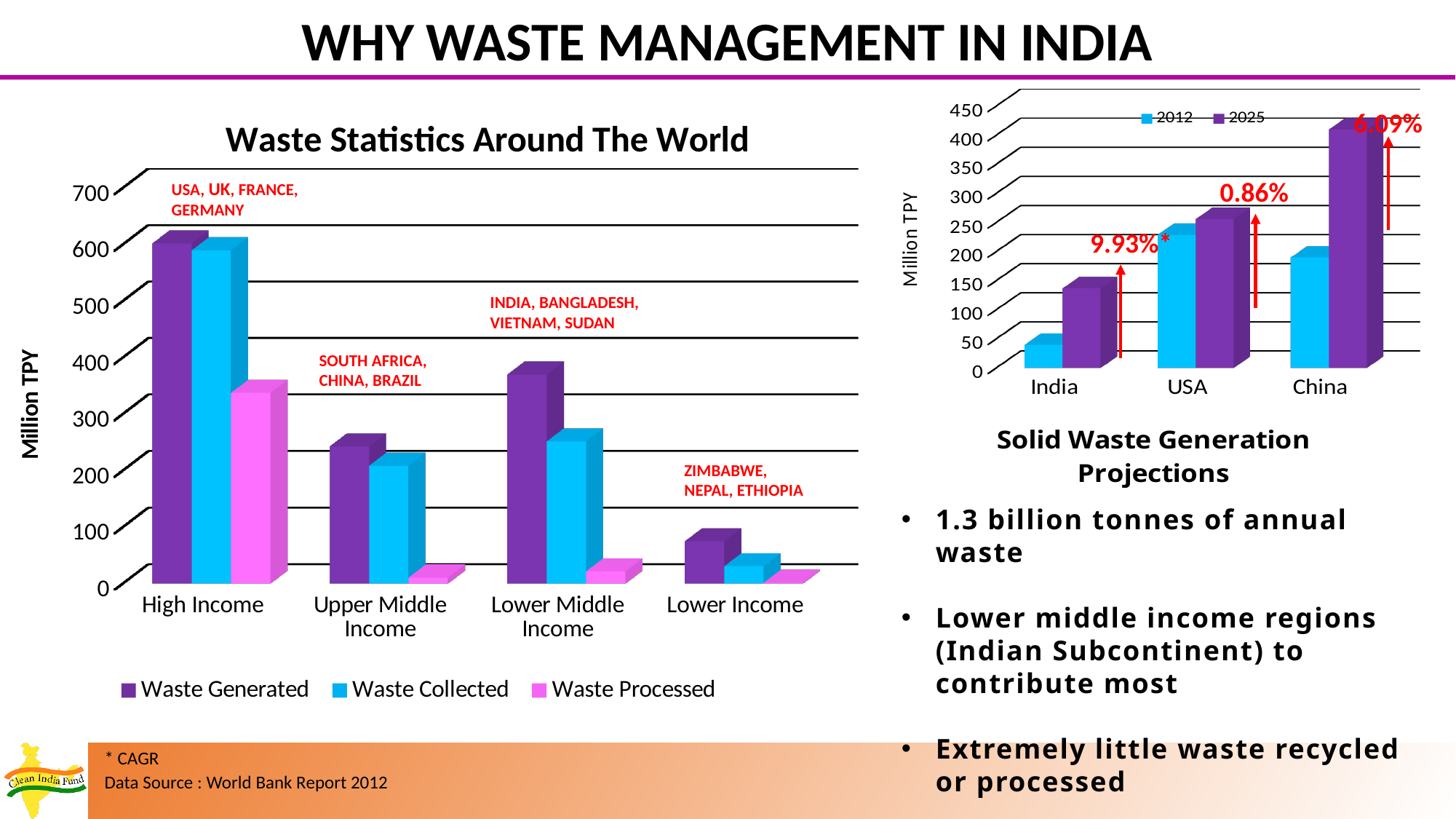
In the 'Solid Waste Generation Projections' chart, which is larger: the 2012 value for USA or for India? USA In the 'Solid Waste Generation Projections' chart, is the 2025 value for China greater or less than 350? greater In the 'Waste Statistics Around The World' chart, how many income categories are shown on the x axis? 4 In the 'Waste Statistics Around The World' chart, is the Waste Generated value for High Income greater or less than 500? greater In the 'Waste Statistics Around The World' chart, how many series does the legend list? 3 In the 'Waste Statistics Around The World' chart, what kind of chart is shown? bar chart In the 'Solid Waste Generation Projections' chart, how many series does the legend list? 2 In the 'Waste Statistics Around The World' chart, which is larger: Waste Generated for Lower Middle Income or for Upper Middle Income? Lower Middle Income In the 'Waste Statistics Around The World' chart, which category has the highest Waste Generated value? High Income In the 'Solid Waste Generation Projections' chart, which country has the highest 2025 value? China In the 'Waste Statistics Around The World' chart, is the Waste Generated value for Lower Income greater or less than 100? less In the 'Waste Statistics Around The World' chart, which category has the lowest Waste Generated value? Lower Income